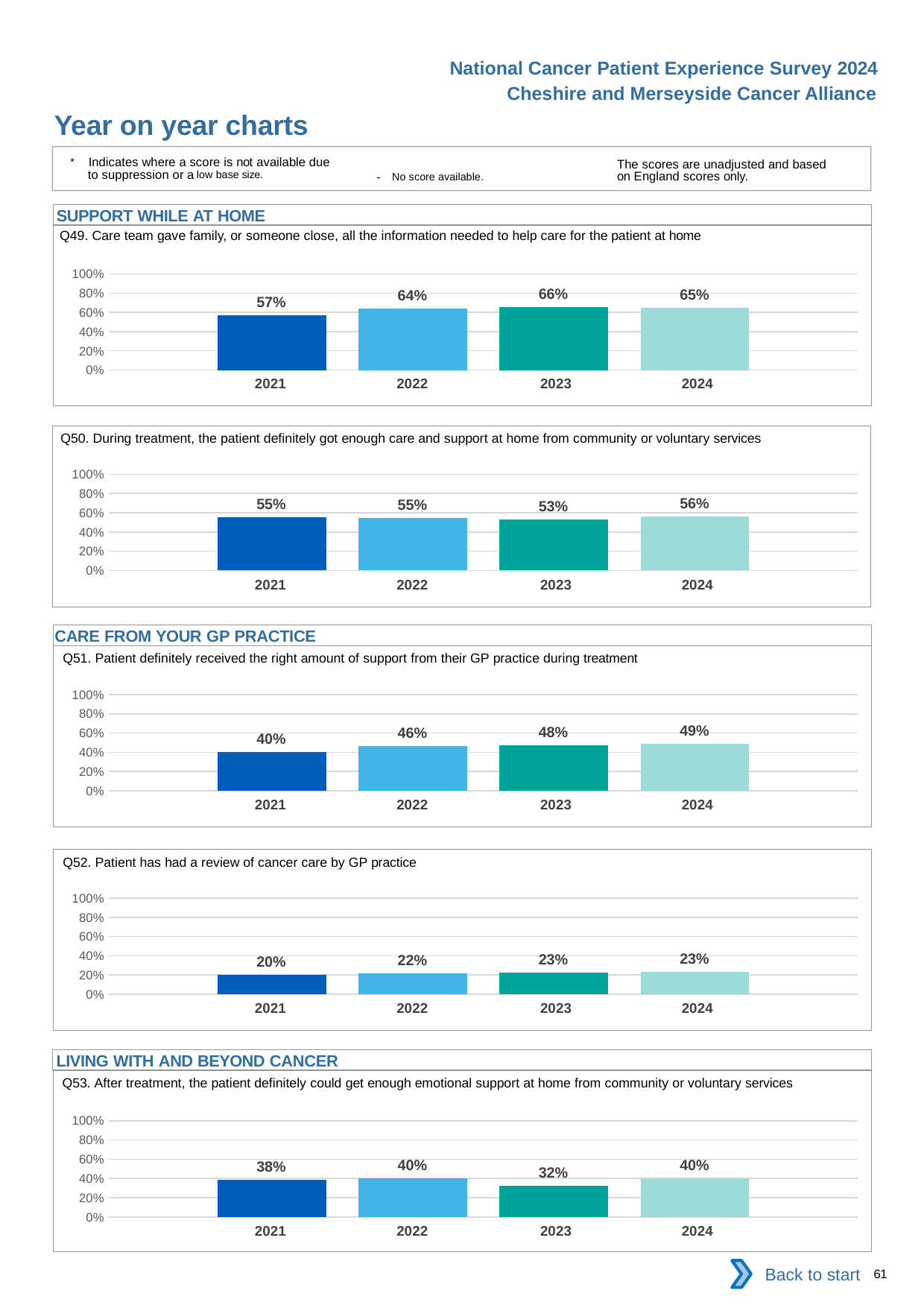
In the Q51 chart, which year has the highest value? 2024 In the Q51 chart, do the values rise or fall from 2021 to 2024? rise In the Q53 chart, which is larger, the value for 2021 or the value for 2023? 2021 In the Q49 chart, what is the value for 2023? 66% In the Q52 chart, what is the value for 2021? 20% In the Q49 chart, which year has the lowest value? 2021 In the Q51 chart, what is the difference between the 2024 value and the 2021 value? 9% In the Q53 chart, which year has the lowest value? 2023 In the Q50 chart, what is the value for 2024? 56% In the Q52 chart, how many years are plotted? 4 What kind of chart is the Q53 chart? bar chart In the Q50 chart, what is the difference between the 2024 value and the 2023 value? 3%